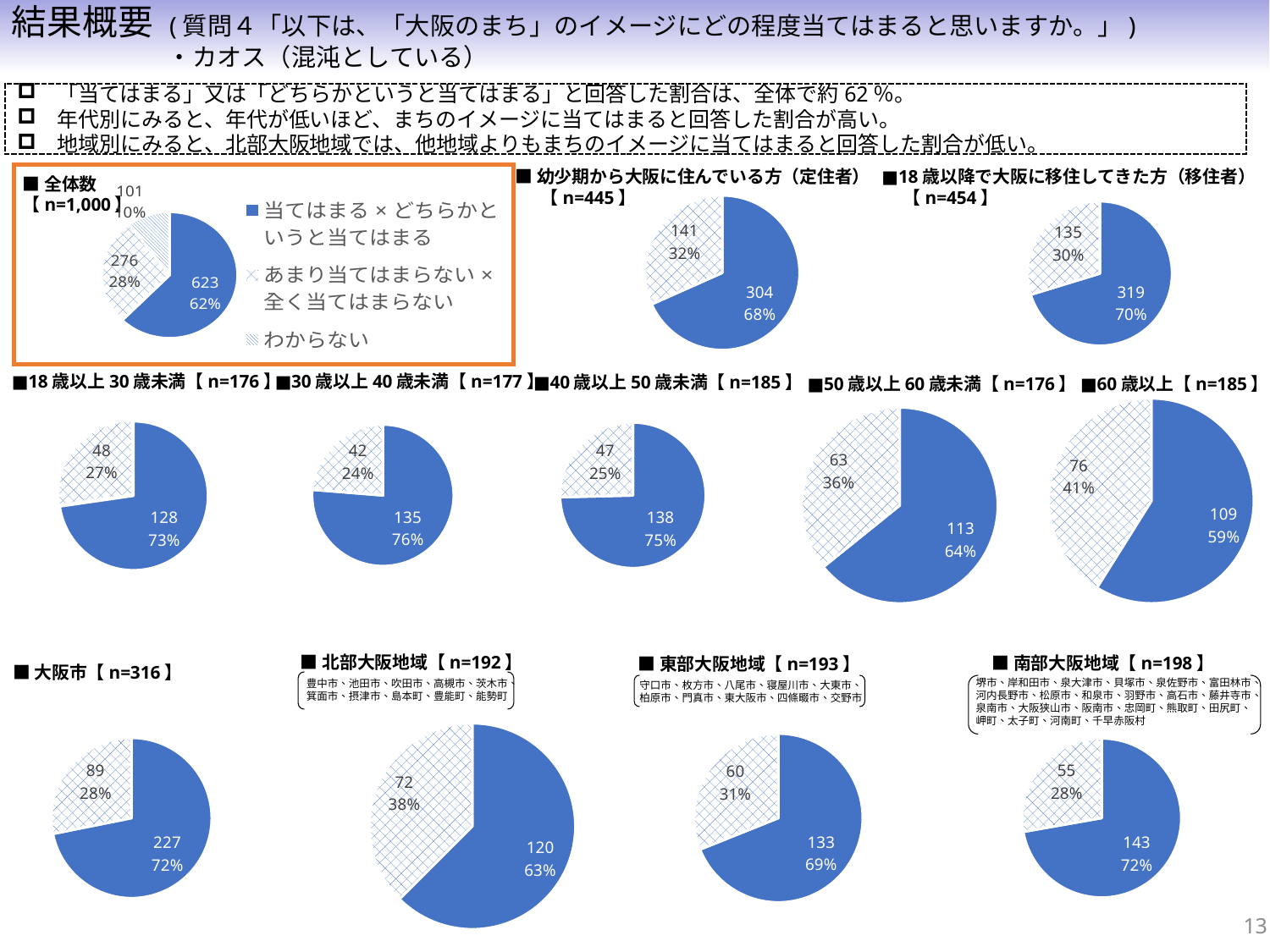
What kind of chart is used for the 幼少期から大阪に住んでいる方（定住者） data? pie chart In the 東部大阪地域 chart, what is the count for the smaller slice? 60 In the 全体数 (n=1,000) chart, how many respondents are in the あまり当てはまらない × 全く当てはまらない slice? 276 In the 60歳以上 chart, what is the difference in count between the two slices (109 and 76)? 33 In the 18歳以降で大阪に移住してきた方（移住者） chart, what is the count for the larger slice? 319 Which is larger: the larger-slice percentage in the 大阪市 chart or in the 北部大阪地域 chart? 大阪市 In the 南部大阪地域 chart, what percentage is shown for the larger slice? 72% Among the five age-group charts (18歳以上30歳未満 through 60歳以上), which has the lowest percentage for the larger slice? 60歳以上 How many entries does the legend next to the 全体数 chart list? 3 How many slices does the 50歳以上60歳未満 pie chart have? 2 In the 30歳以上40歳未満 chart, what percentage is shown for the larger slice? 76% In the 全体数 (n=1,000) chart, what percentage is shown for the 当てはまる × どちらかというと当てはまる slice? 62%